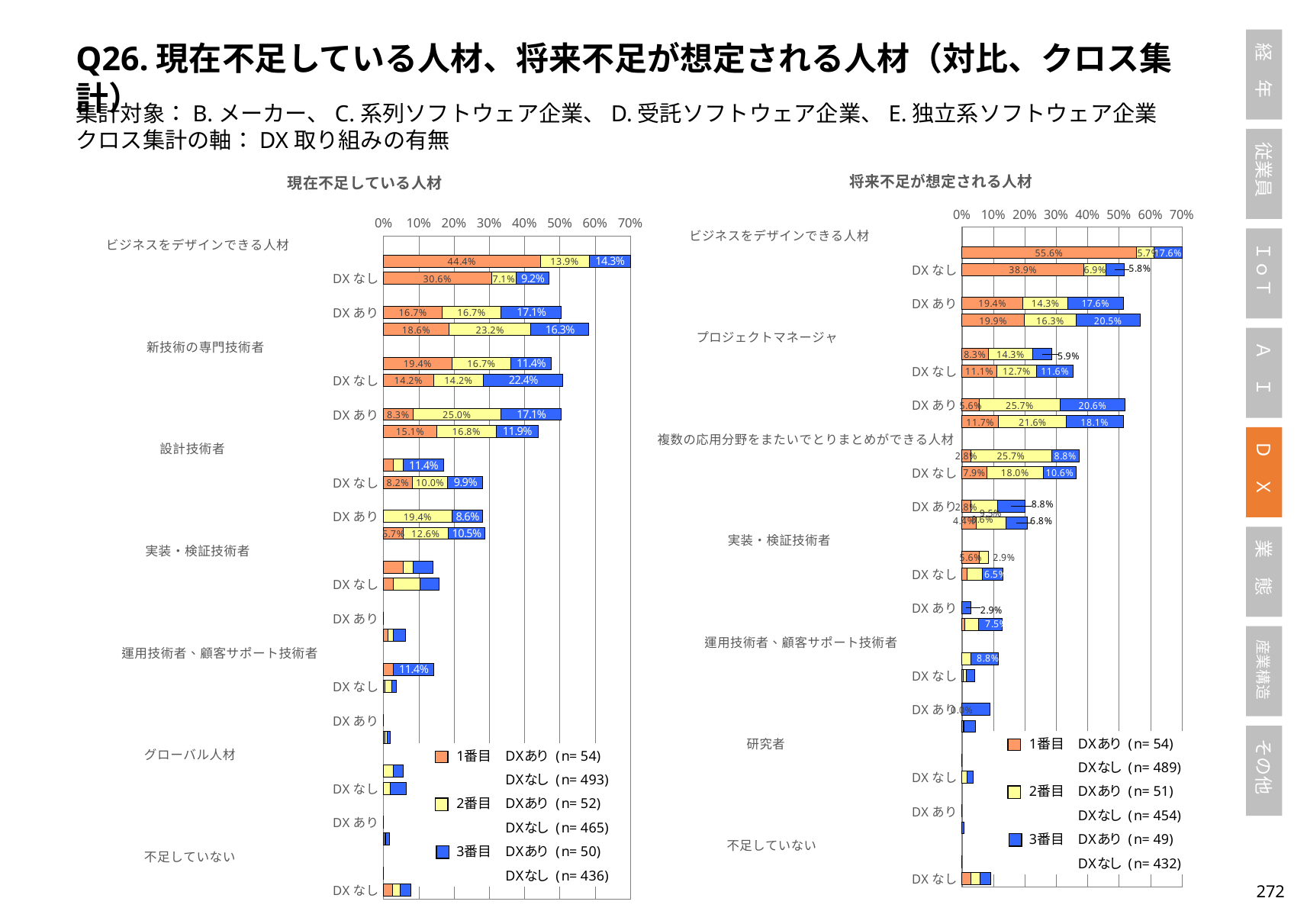
Which is larger: the largest 1番目 value in the left chart (44.4%) or the largest 1番目 value in the right chart (55.6%)? the right chart (55.6%) What is the highest value shown on the horizontal axis of the right chart (将来不足が想定される人材)? 70% In the left chart (現在不足している人材), what is the largest 1番目 (orange) value labelled? 44.4% How many series does the legend of the left chart (現在不足している人材) list? 3 What is the difference between the largest 1番目 value in the right chart (55.6%) and the largest 1番目 value in the left chart (44.4%)? 11.2 percentage points In the right chart (将来不足が想定される人材), what is the largest 1番目 (orange) value labelled? 55.6% In the left chart (現在不足している人材), what is the n for DXなし in the 1番目 series according to the legend? 493 In the right chart (将来不足が想定される人材), what is the n for DXなし in the 3番目 series according to the legend? 432 What kind of chart is the left chart titled 現在不足している人材? bar chart In the right chart (将来不足が想定される人材), is the total length of the topmost bar for ビジネスをデザインできる人材 greater or less than 60%? greater What is the title of the right chart? 将来不足が想定される人材